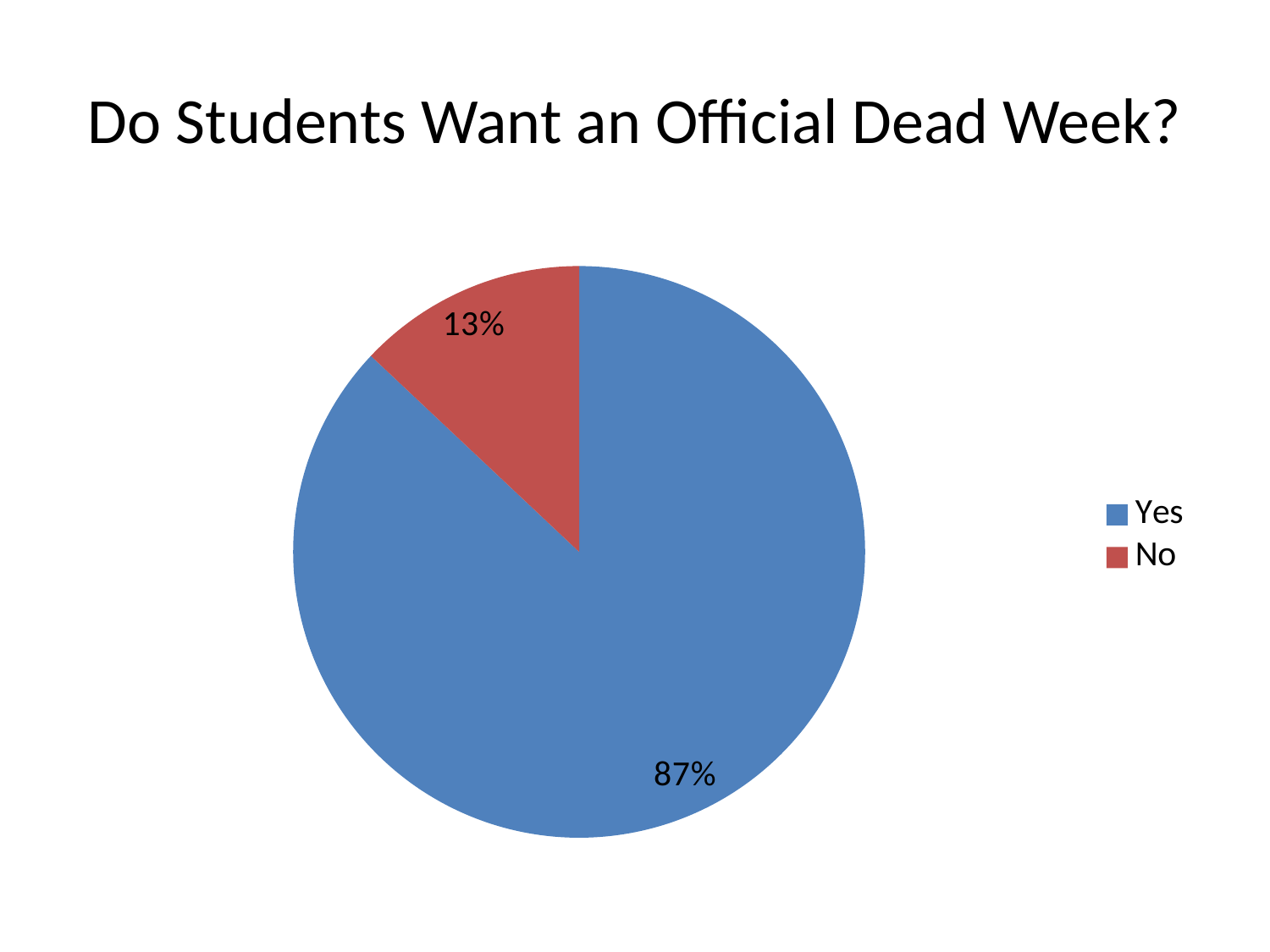
What colour is the Yes slice? Blue What percentage of students answered Yes? 87% Which category has the largest share of the pie? Yes How many categories does the pie chart show? 2 What kind of chart is shown on the slide? Pie chart What is the difference in percentage points between the Yes and No slices? 74 How many entries does the legend list? 2 What share of the pie does the No slice represent? 13% Which category has the smallest share of the pie? No What is the title of the slide? Do Students Want an Official Dead Week? Which slice is larger, Yes or No? Yes What percentage of students answered No? 13%